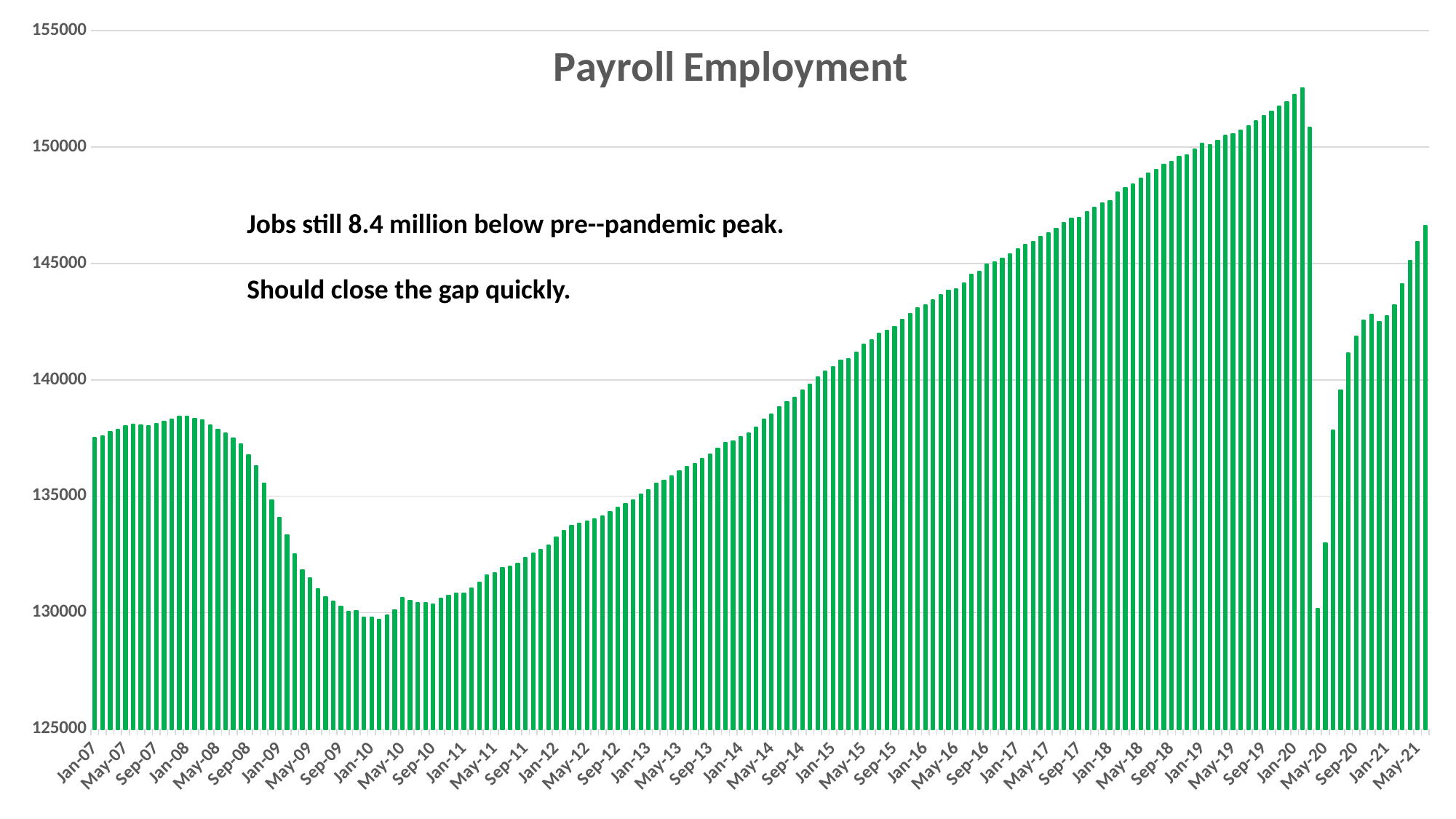
What is the title of the chart? Payroll Employment Is the value for Jan-20 greater or less than 150000? greater Is the value for May-20 greater or less than 135000? less Is the value for Jan-10 greater or less than 135000? less Which is larger, the value for Jan-20 or the value for May-21? Jan-20 Which is larger, the value for Jan-08 or the value for Jan-10? Jan-08 Do the values rise or fall between Jan-10 and Jan-20? rise What colour are the bars in the chart? green What kind of chart is shown on the slide? bar chart